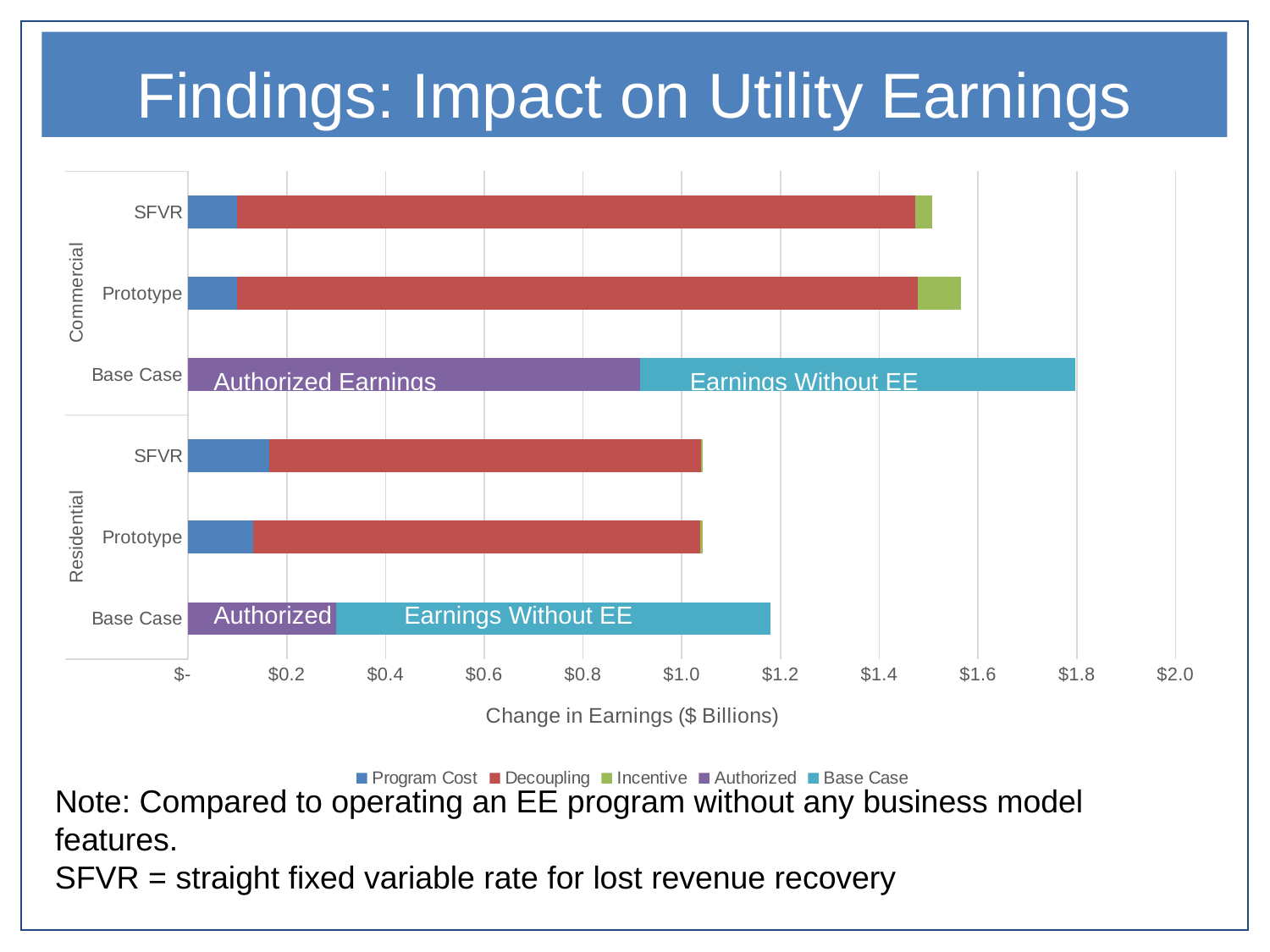
Which bar is the longest in the chart? Commercial Base Case Which bar is longer, the Commercial Base Case bar or the Residential Base Case bar? Commercial Base Case What is the title of the horizontal axis? Change in Earnings ($ Billions) Is the total value for the Commercial Base Case bar greater or less than $1.6? greater How many bars are plotted in the chart? 6 What kind of chart is shown on the slide? Stacked bar chart Which legend entry is shown in red? Decoupling Is the total value for the Commercial Prototype bar greater or less than $1.6? less Is the total value for the Commercial SFVR bar greater or less than $1.4? greater How many series does the legend list? 5